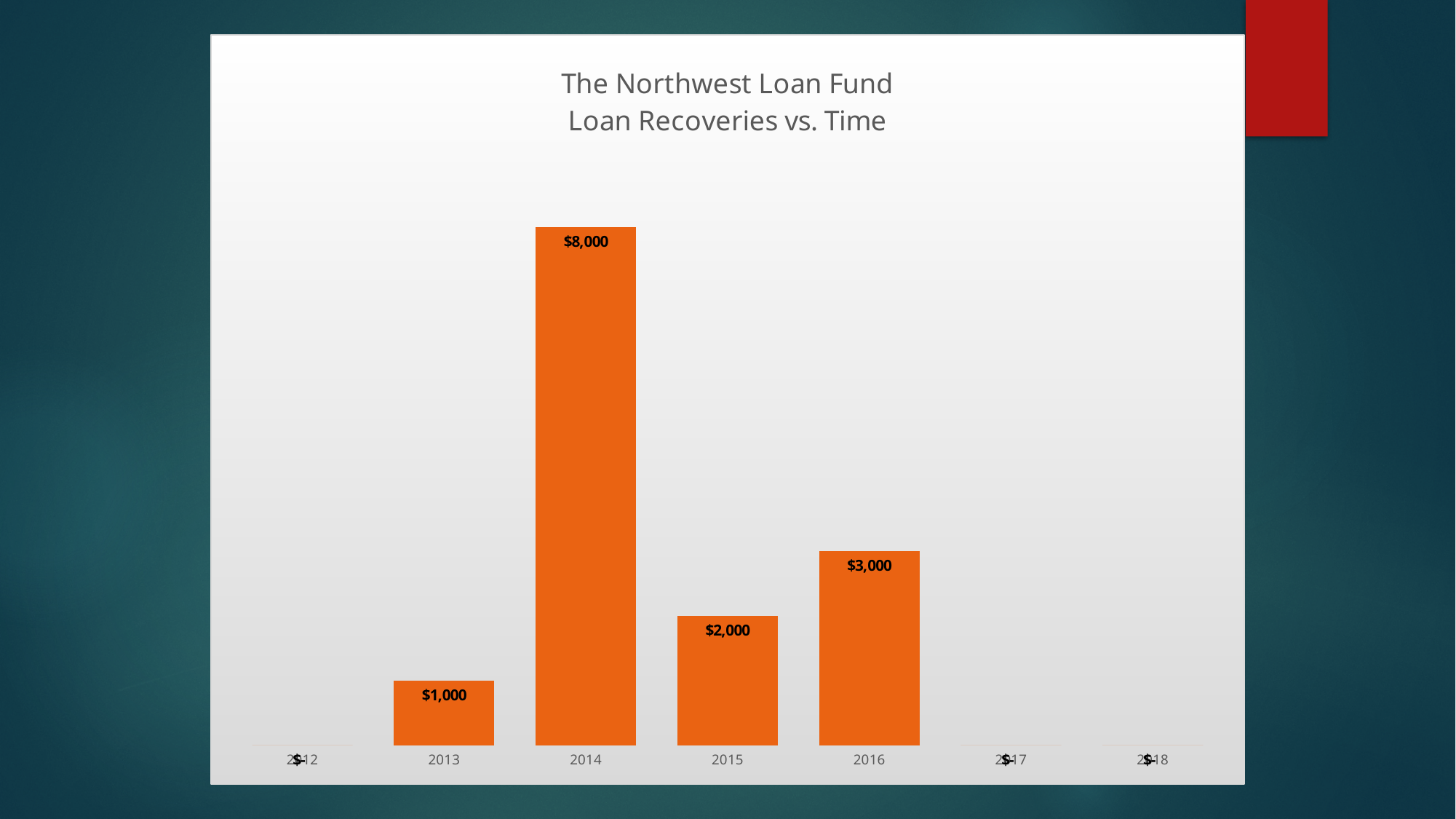
What is the loan recovery value for 2015? $2,000 What is the title of the chart? The Northwest Loan Fund Loan Recoveries vs. Time What is the difference between the loan recoveries in 2016 and 2015? $1,000 How many years are shown on the x axis of the chart? 7 What is the loan recovery value for 2016? $3,000 What is the loan recovery value for 2014? $8,000 What is the difference between the loan recoveries in 2014 and 2016? $5,000 What kind of chart is shown on the slide? Bar chart Among the years with a visible bar, which year has the lowest loan recoveries? 2013 What is the loan recovery value for 2013? $1,000 Which year has the highest loan recoveries? 2014 Which year has larger loan recoveries, 2015 or 2016? 2016